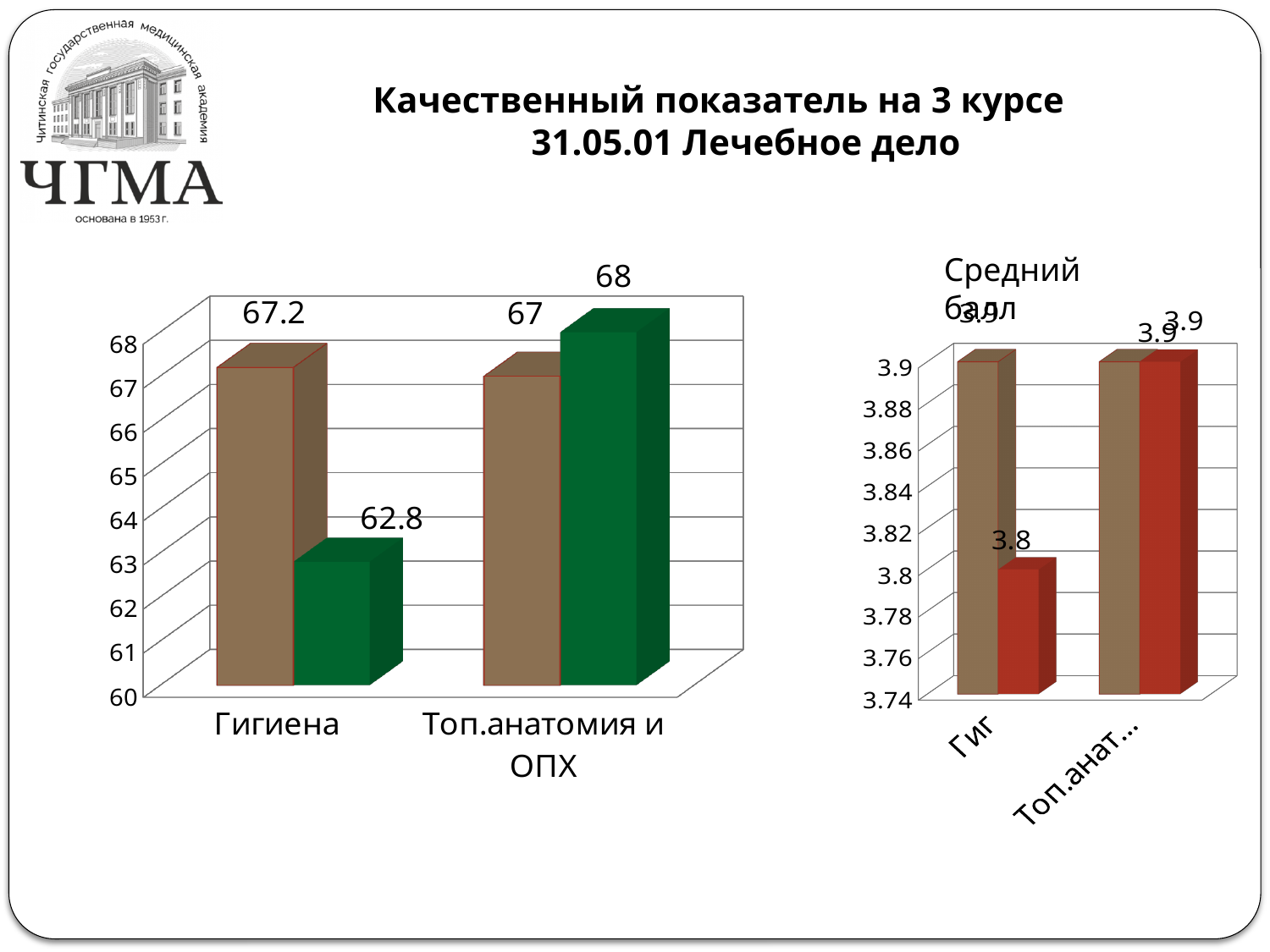
In the left chart, what is the value of the brown bar for Гигиена? 67.2 In the left chart, what is the value of the brown bar for Топ.анатомия и ОПХ? 67 In the right chart (Средний балл), what is the value of the brown bar for Гиг? 3.9 In the left chart, what is the difference between the brown and green bars for Гигиена? 4.4 In the left chart, what is the value of the green bar for Топ.анатомия и ОПХ? 68 What is the title of the right chart? Средний балл How many categories are shown on the x axis of the left chart? 2 In the left chart, which is larger for Топ.анатомия и ОПХ: the brown bar or the green bar? The green bar In the right chart (Средний балл), what is the value of the red bar for Гиг? 3.8 What type of chart is the left chart? Bar chart In the left chart, what is the value of the green bar for Гигиена? 62.8 In the left chart, which bar has the lowest value? The green bar for Гигиена (62.8)